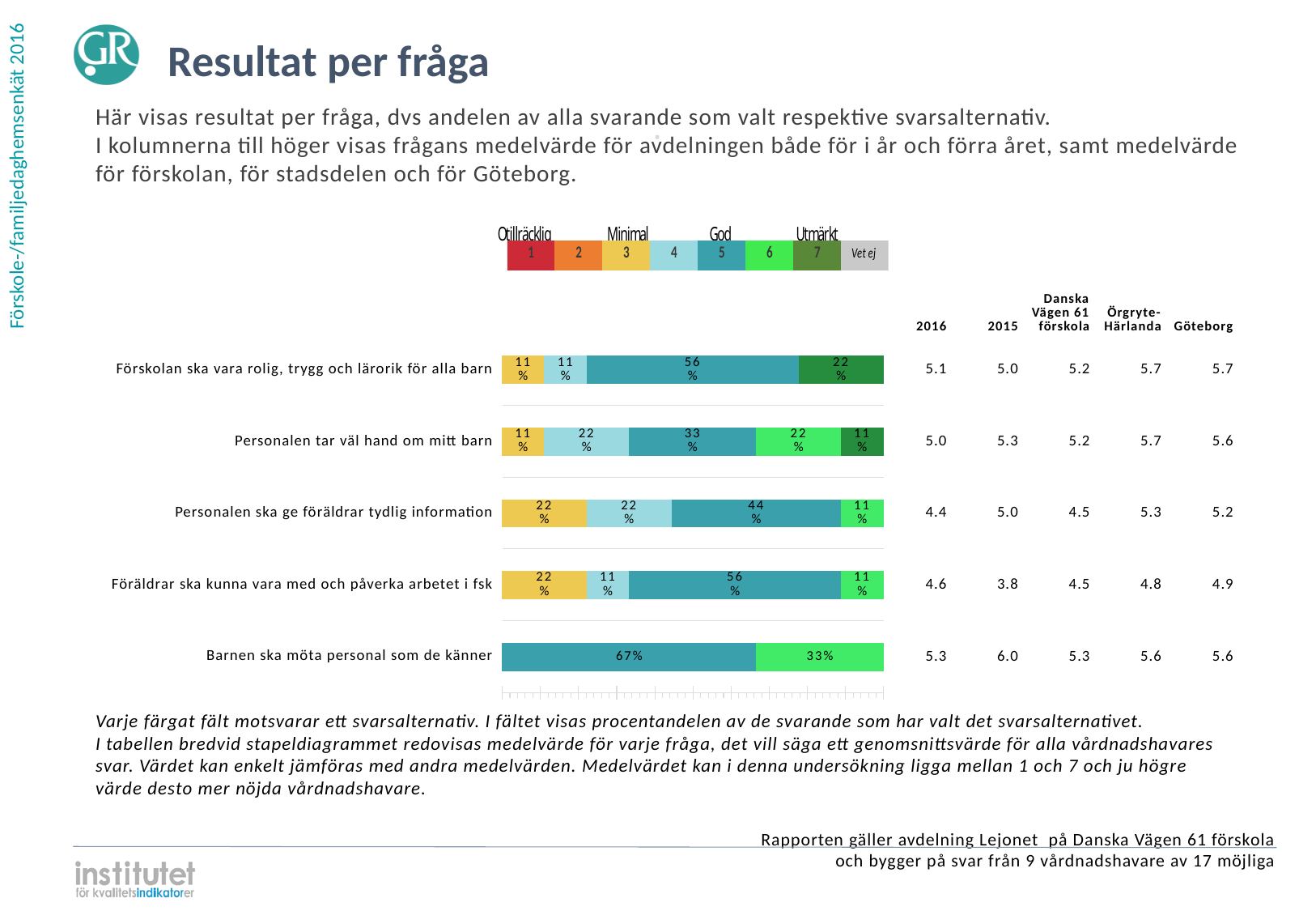
Which question has the highest 2016 mean value in the table next to the chart? Barnen ska möta personal som de känner (5.3) What is the 2015 mean value for 'Föräldrar ska kunna vara med och påverka arbetet i fsk'? 3.8 What kind of chart is used to show the share of respondents per answer alternative? Stacked bar chart How many questions (categories) are shown in the bar chart? 5 Which colour represents the 'Utmärkt' (7) answer alternative in the legend? Dark green What percentage of respondents chose alternative 7 (Utmärkt) for 'Förskolan ska vara rolig, trygg och lärorik för alla barn'? 22% What is the difference between the 'God' (5) segment and the 'Minimal' (3) segment for 'Föräldrar ska kunna vara med och påverka arbetet i fsk'? 34 percentage points What percentage of respondents chose the 'God' (5) alternative for 'Barnen ska möta personal som de känner'? 67% What is the total of the two segments in the bar for 'Barnen ska möta personal som de känner'? 100% What is the largest segment in the bar for 'Personalen ska ge föräldrar tydlig information'? 44% How many answer alternatives does the colour legend above the chart list? 8 Which is larger for 'Personalen tar väl hand om mitt barn': the alternative 4 segment or the alternative 5 segment? Alternative 5 (33%)